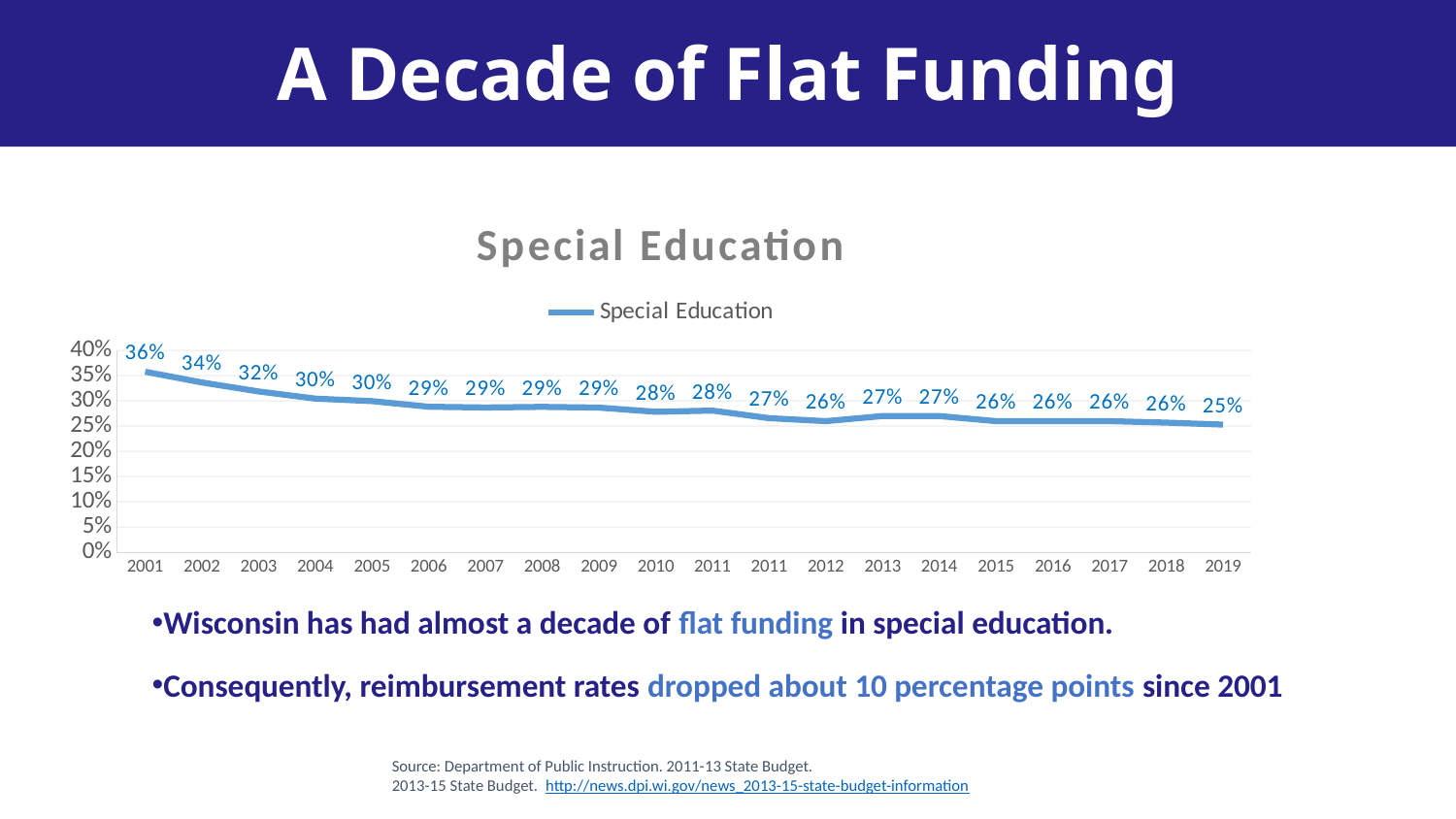
How many series does the legend list? 1 What value is shown for 2010? 28% What kind of chart is shown on the slide? line chart How many data points are plotted on the line? 20 Which is larger, the value for 2002 or the value for 2012? 2002 Which year has the lowest value on the chart? 2019 By how many percentage points did the value fall from 2001 to 2019? 11 percentage points Which year has the highest value on the chart? 2001 Do the values generally rise or fall from 2001 to 2019? fall What is the Special Education reimbursement rate for 2001? 36% What is the Special Education reimbursement rate for 2019? 25% What value is shown for 2005? 30%